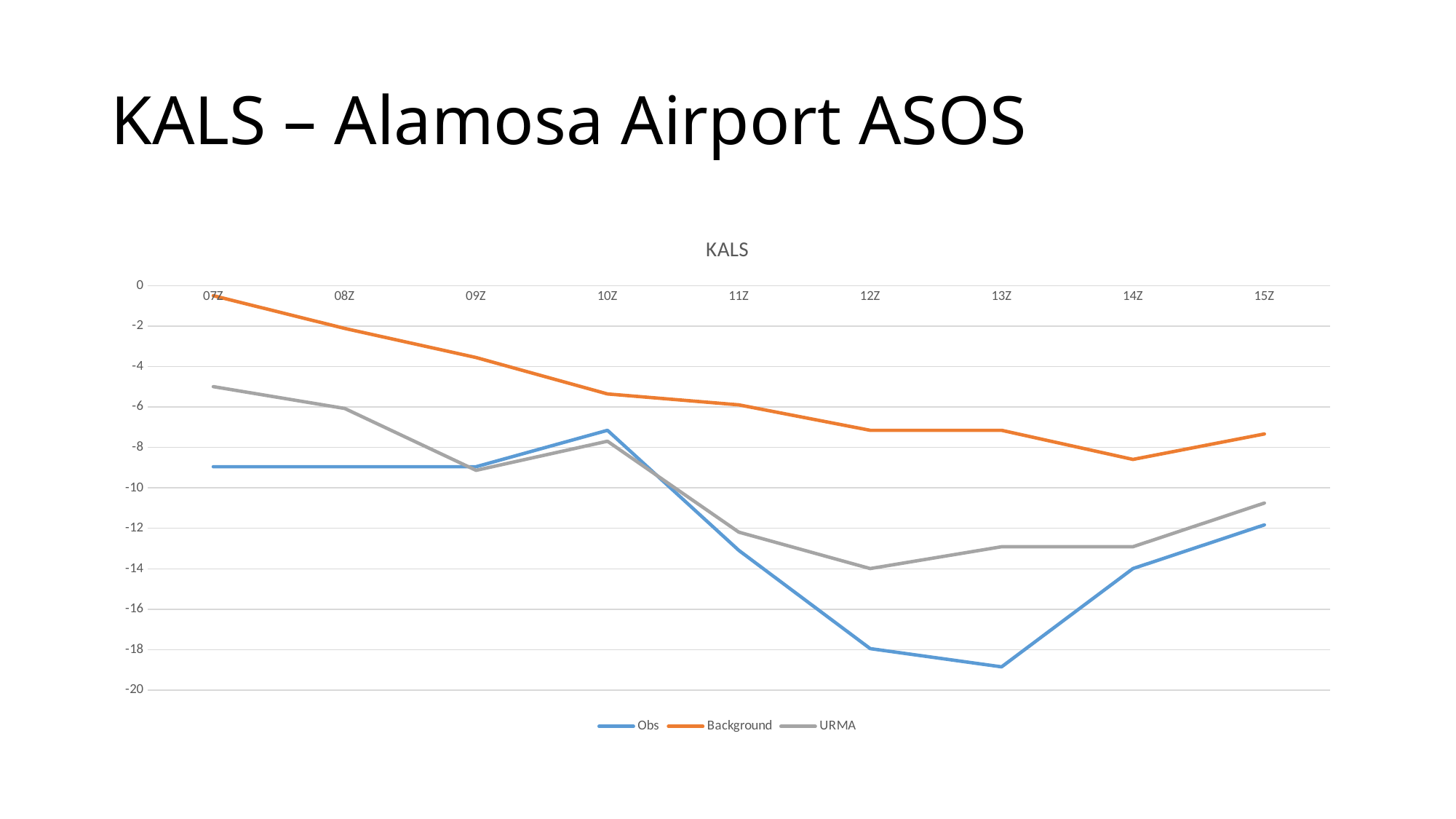
Is the Obs value at 13Z greater or less than -18? less At which time does the Background series reach its lowest value? 14Z What is the title of the chart? KALS At which time does the URMA series reach its lowest value? 12Z Which series is drawn in orange? Background At which time is the Background series highest? 07Z At which time does the Obs series reach its lowest value? 13Z At 11Z, which is larger, the Obs value or the URMA value? URMA Is the Background value at 12Z greater or less than -8? greater How many series does the legend list? 3 What kind of chart is shown on the slide? line chart How many time points are shown along the x axis? 9